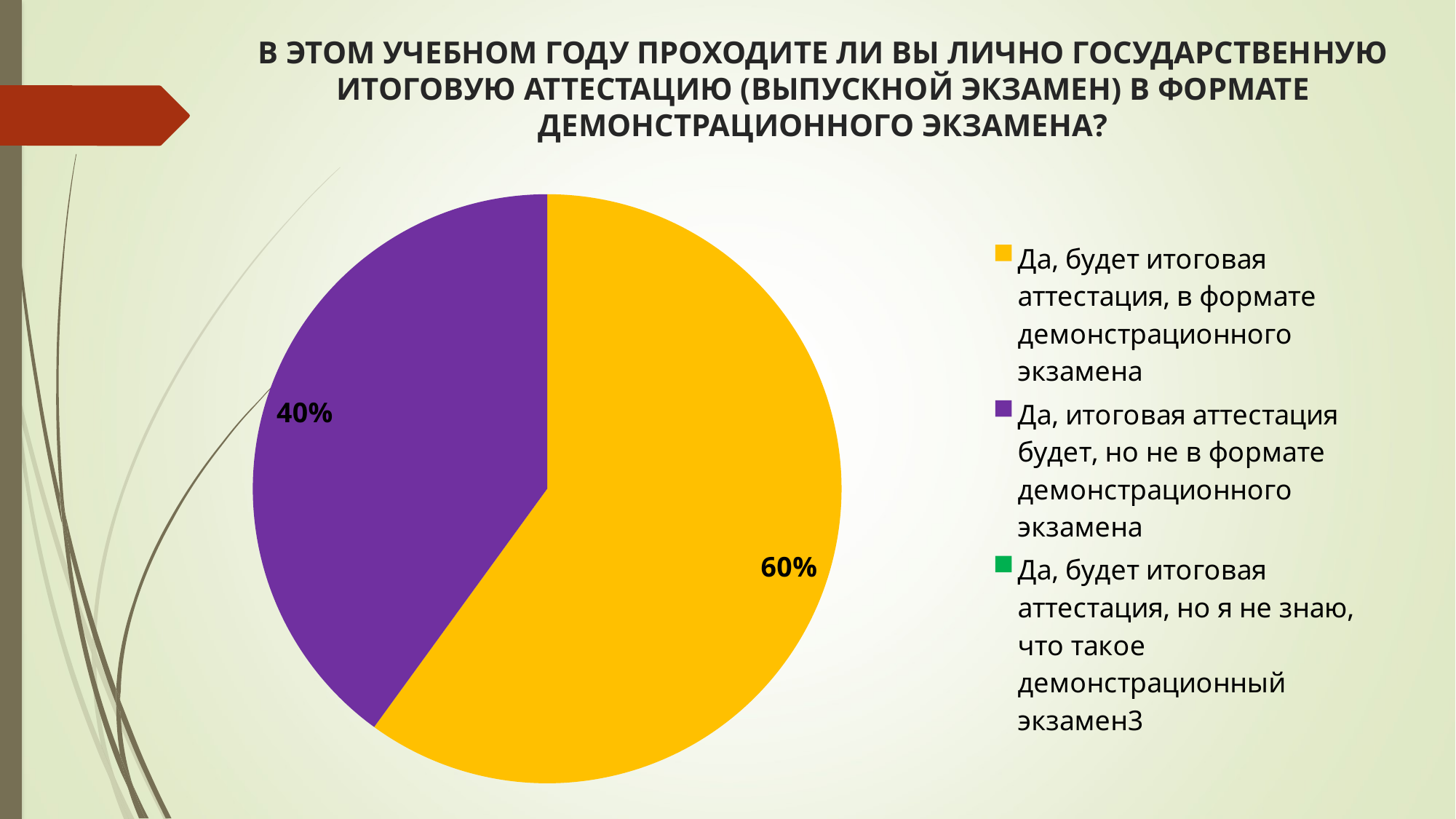
What is the difference in percentage points between the 60% slice and the 40% slice? 20% Which is larger: the share for "Да, будет итоговая аттестация, в формате демонстрационного экзамена" or the share for "Да, итоговая аттестация будет, но не в формате демонстрационного экзамена"? Да, будет итоговая аттестация, в формате демонстрационного экзамена What colour is the slice labelled 60%? yellow Which category has the largest slice of the pie? Да, будет итоговая аттестация, в формате демонстрационного экзамена What colour is the slice labelled 40%? purple What kind of chart is shown on the slide? pie chart What is the share of the yellow slice? 60% How many slices are visible in the pie chart? 2 How many entries does the legend list? 3 What share of the pie does the slice "Да, итоговая аттестация будет, но не в формате демонстрационного экзамена" have? 40% What is the share of the purple slice? 40% What share of the pie does the slice "Да, будет итоговая аттестация, в формате демонстрационного экзамена" have? 60%